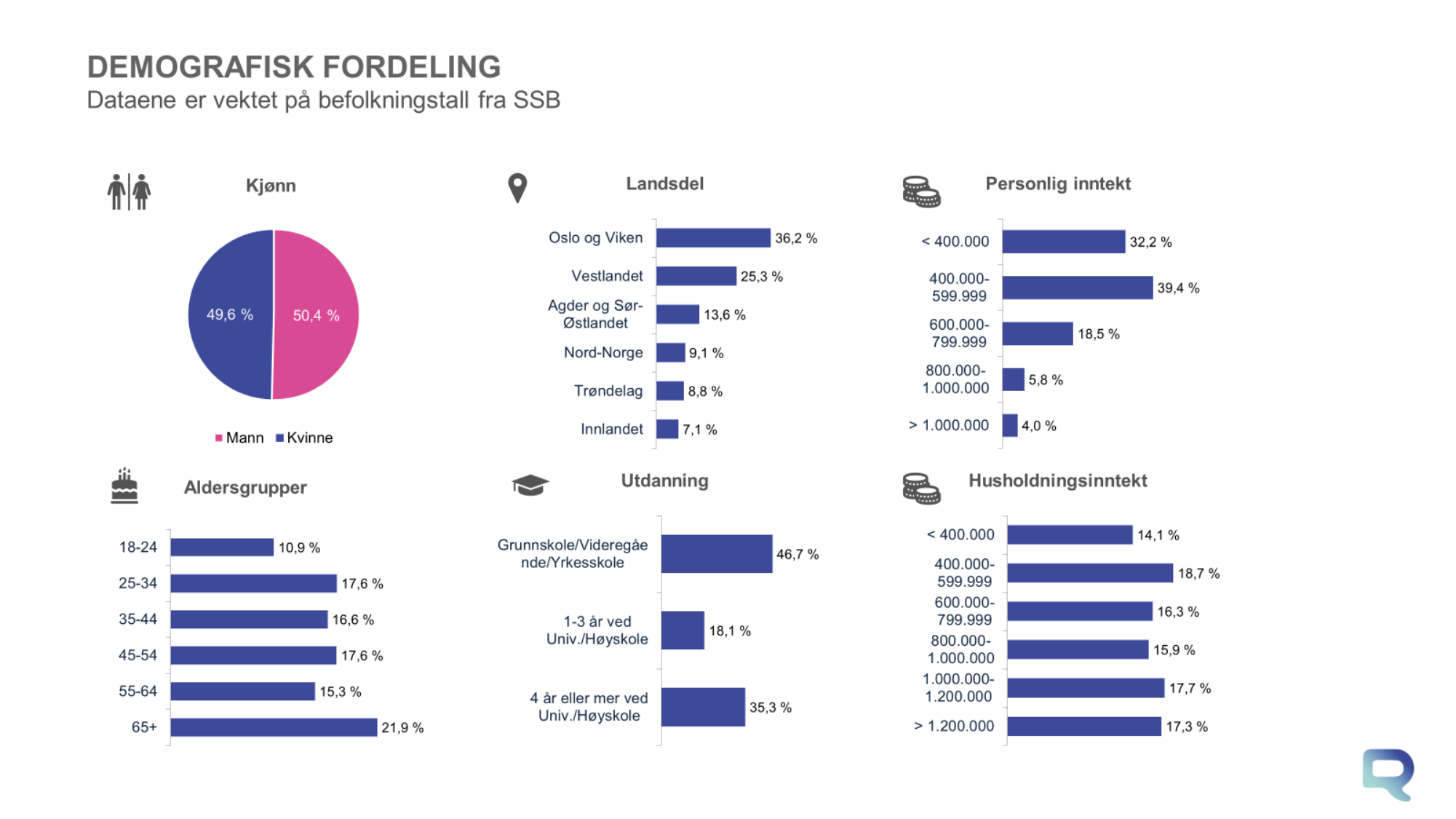
In the Husholdningsinntekt chart, which income group has the lowest value? < 400.000 In the Personlig inntekt chart, what is the value for > 1.000.000? 4,0 % In the Personlig inntekt chart, which income group has the highest value? 400.000-599.999 What kind of chart is the Kjønn chart? pie chart In the Landsdel chart, which region has the lowest value? Innlandet In the Aldersgrupper chart, how many age groups are shown? 6 In the Husholdningsinntekt chart, what is the value for 1.000.000-1.200.000? 17,7 % In the Landsdel chart, what is the value for Vestlandet? 25,3 % In the Kjønn chart, what share is shown for Mann? 50,4 % In the Aldersgrupper chart, which age group has the highest value? 65+ In the Landsdel chart, what is the difference between Oslo og Viken and Nord-Norge? 27,1 % In the Utdanning chart, which is larger: 1-3 år ved Univ./Høyskole or 4 år eller mer ved Univ./Høyskole? 4 år eller mer ved Univ./Høyskole